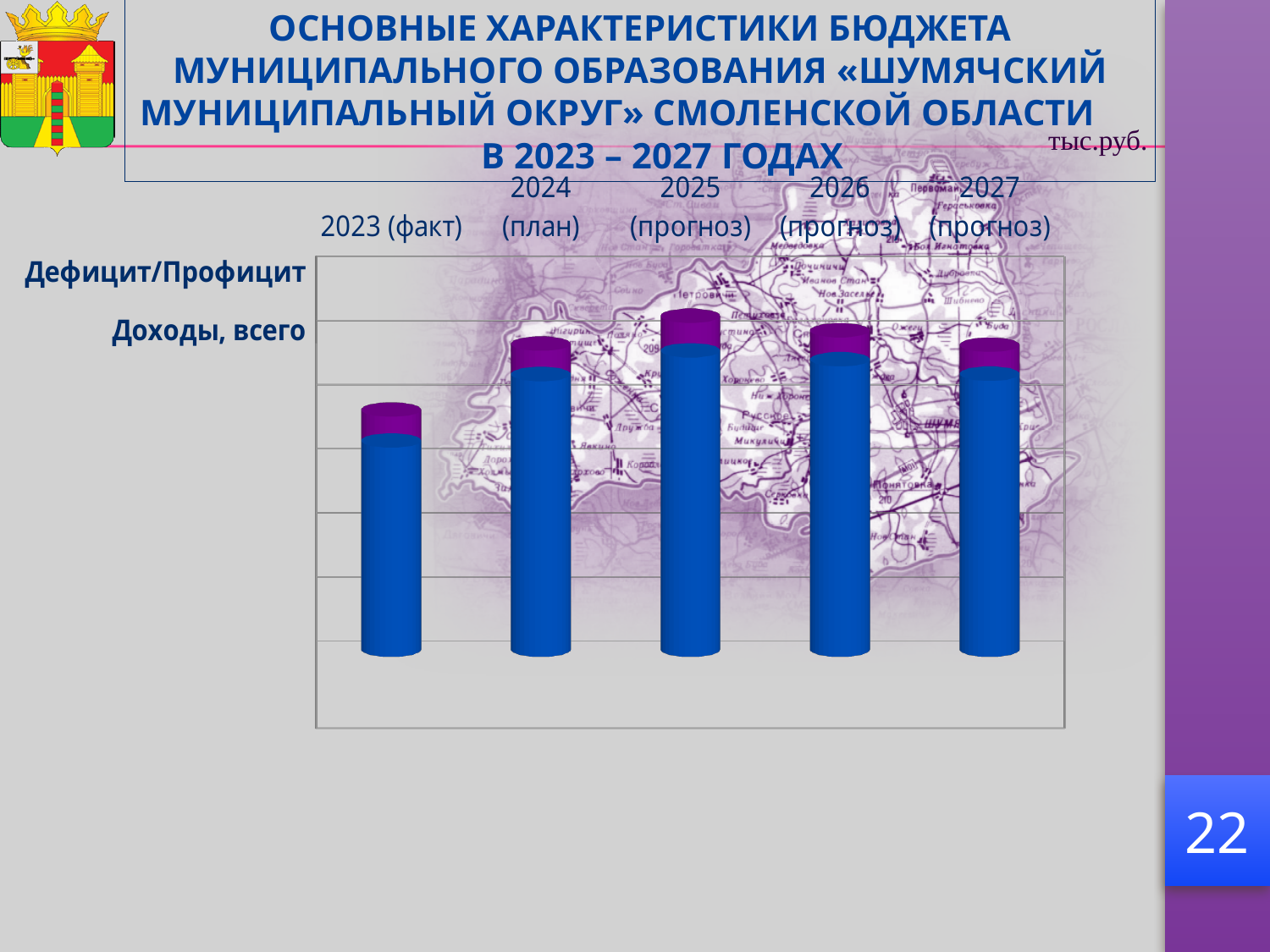
What kind of chart is shown on the slide? bar chart What unit of measurement is indicated for the chart values? тыс.руб. Which year has the tallest bar on the chart? 2025 (прогноз) Which bar is taller: 2025 (прогноз) or 2027 (прогноз)? 2025 (прогноз) Do the bar heights rise or fall from 2025 (прогноз) to 2027 (прогноз)? fall Which year has the shortest bar on the chart? 2023 (факт) Do the bar heights rise or fall from 2023 (факт) to 2025 (прогноз)? rise How many years (categories) are plotted on the chart? 5 Which bar is taller: 2023 (факт) or 2024 (план)? 2024 (план)